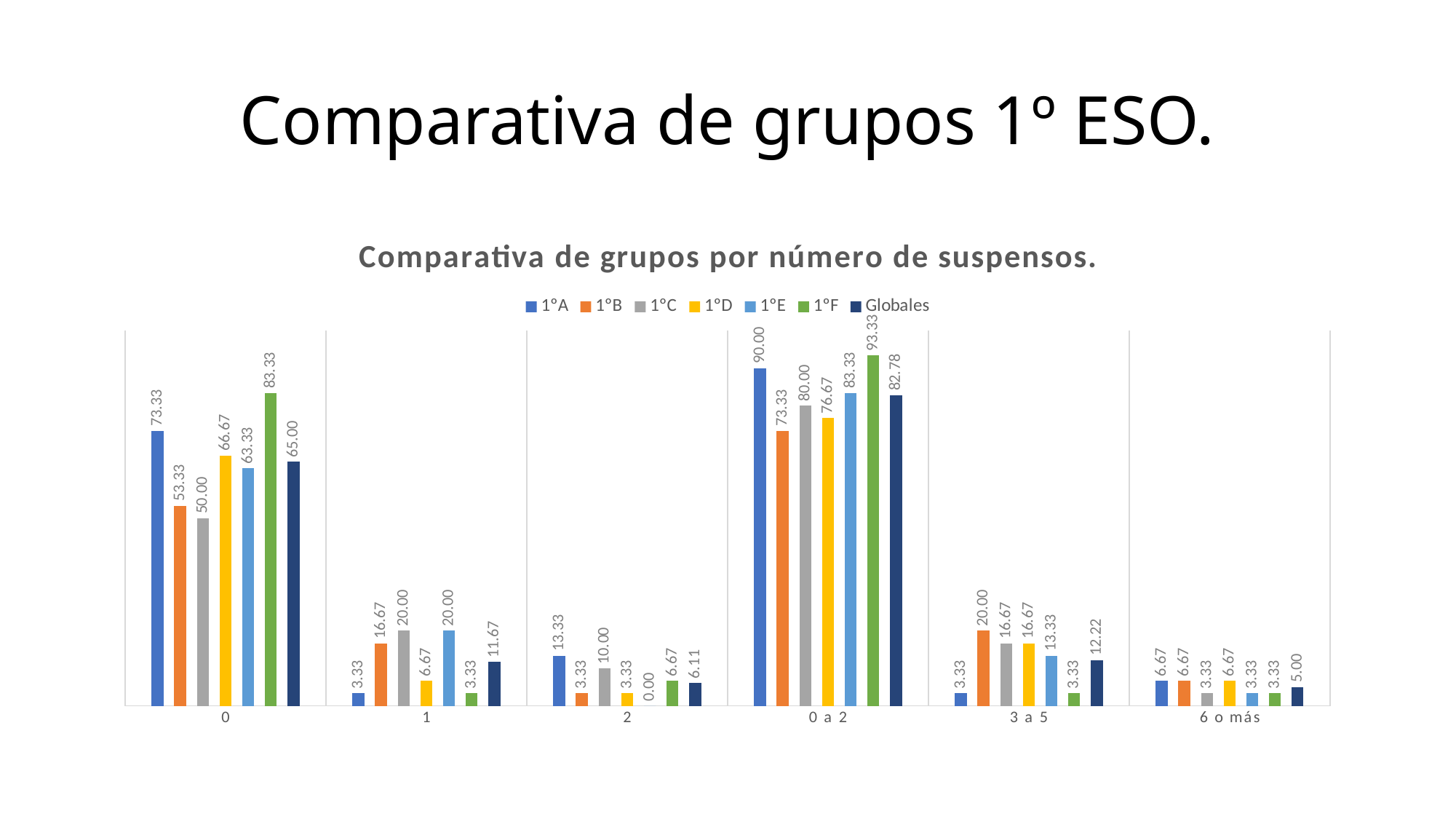
What is the value for 1ºF in the "0" category? 83.33 What is the difference between 1ºA and 1ºB in the "0 a 2" category? 16.67 What kind of chart is shown on the slide? Bar chart What is the value for 1ºB in the "3 a 5" category? 20.00 What is the title of the chart? Comparativa de grupos por número de suspensos. Which group has the lowest value in the "0" category? 1ºC Which group has the highest value in the "0 a 2" category? 1ºF What is the value for Globales in the "0 a 2" category? 82.78 In the "3 a 5" category, which is larger: 1ºB or 1ºE? 1ºB How many categories are shown on the x axis? 6 What is the value for 1ºE in the "2" category? 0.00 How many series does the legend list? 7